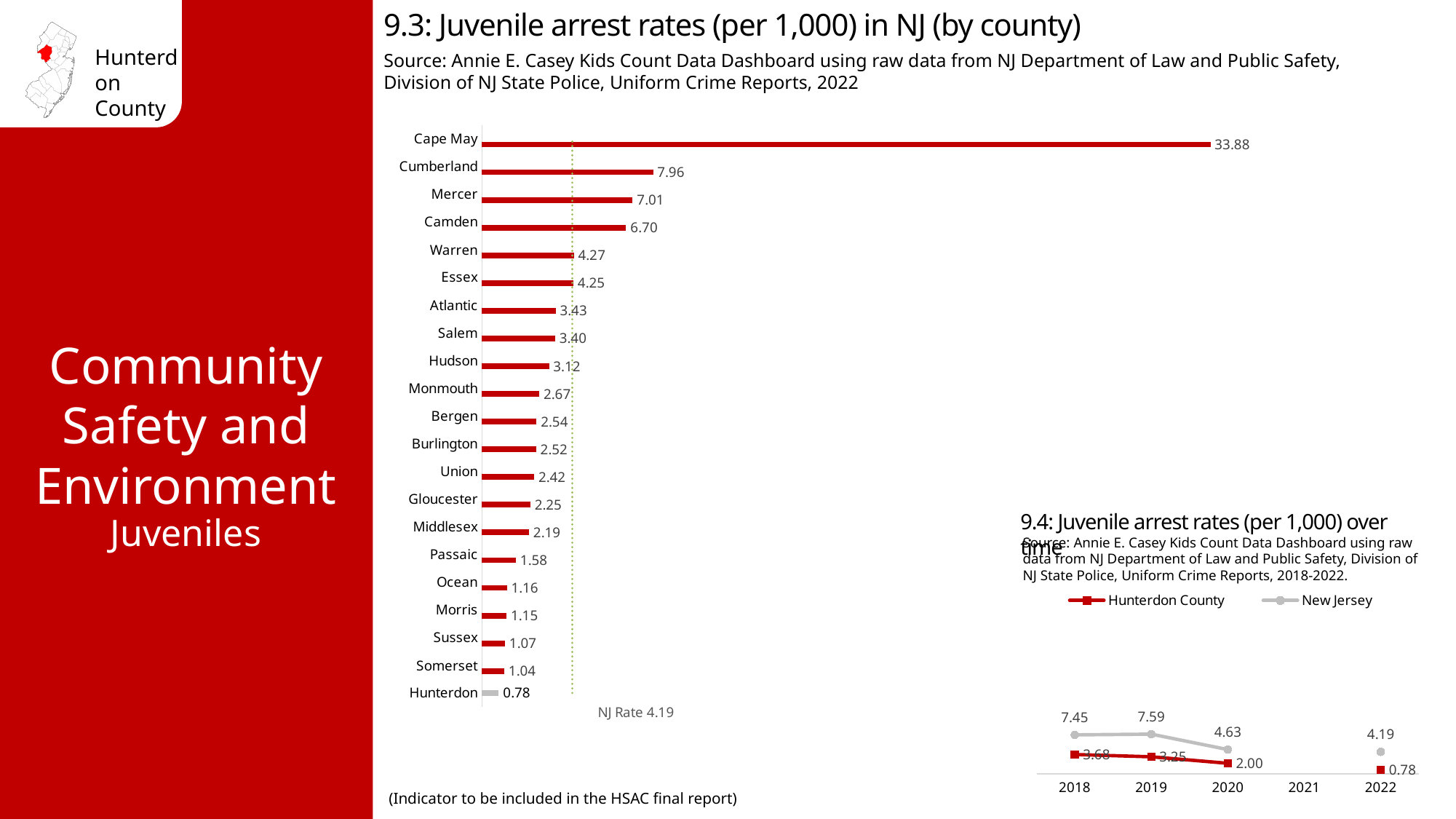
In chart 9.3 (juvenile arrest rates by county), which county has a higher juvenile arrest rate, Camden or Warren? Camden In chart 9.3 (juvenile arrest rates by county), what is the juvenile arrest rate for Cape May? 33.88 In chart 9.4 (juvenile arrest rates over time), what was the New Jersey rate in 2019? 7.59 In chart 9.3 (juvenile arrest rates by county), how many counties are shown? 21 In chart 9.4 (juvenile arrest rates over time), what was the Hunterdon County rate in 2020? 2.00 In chart 9.3 (juvenile arrest rates by county), which county has the highest juvenile arrest rate? Cape May In chart 9.3 (juvenile arrest rates by county), what NJ rate is marked by the dotted reference line? 4.19 In chart 9.4 (juvenile arrest rates over time), how many series does the legend list? 2 In chart 9.3 (juvenile arrest rates by county), which county has the lowest juvenile arrest rate? Hunterdon In chart 9.3 (juvenile arrest rates by county), what is the difference between the rates for Cumberland and Mercer? 0.95 In chart 9.3 (juvenile arrest rates by county), what is the juvenile arrest rate for Hunterdon? 0.78 What kind of chart is chart 9.3 (juvenile arrest rates by county)? Bar chart